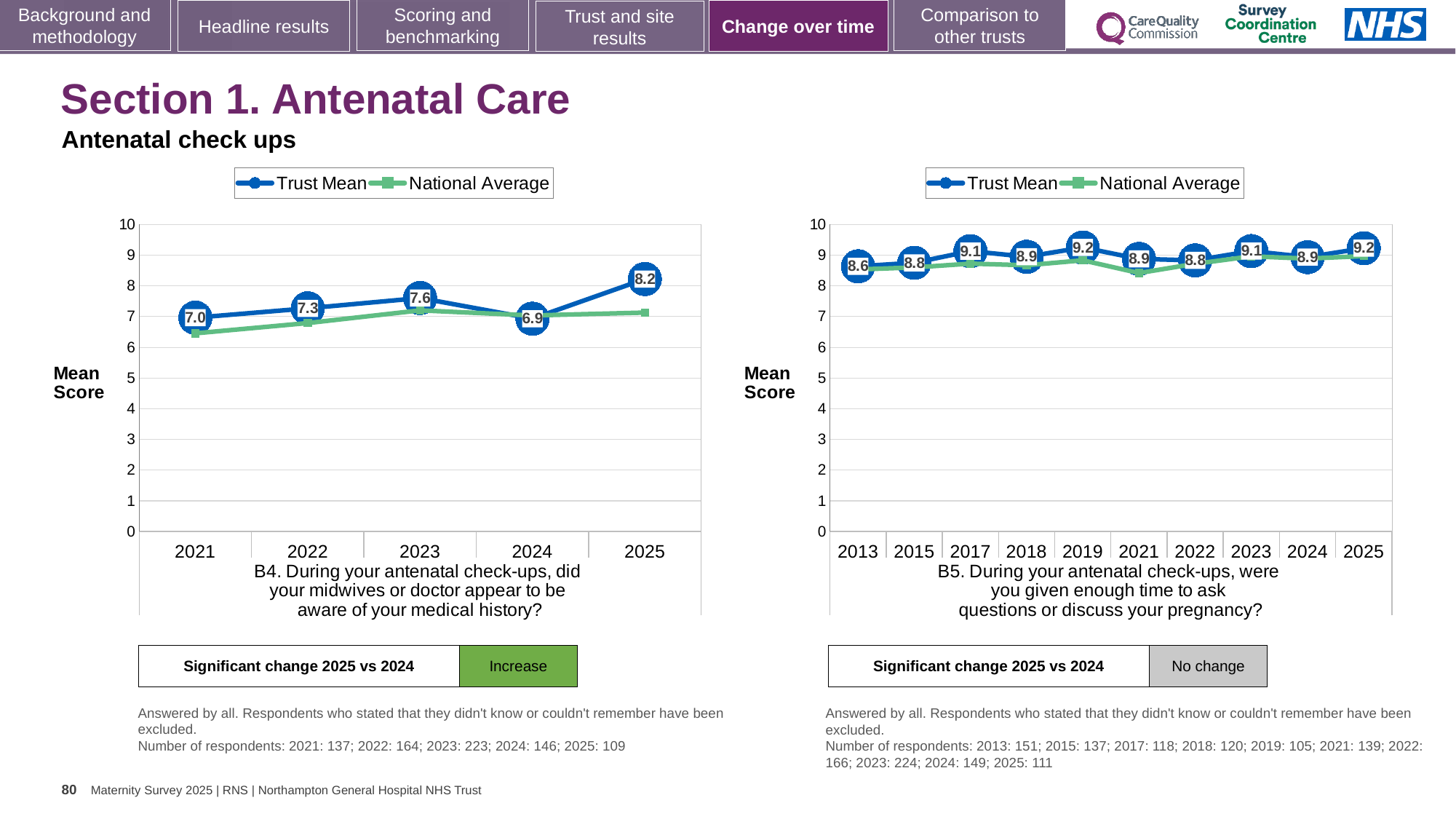
On the left chart (B4), is the National Average value for 2021 greater or less than 7? less On the right chart (B5), what is the Trust Mean score for 2013? 8.6 On the left chart (B4), what is the difference between the Trust Mean scores for 2025 and 2024? 1.3 On the left chart (B4), which year has the lowest Trust Mean score? 2024 On the right chart (B5), is the Trust Mean score for 2019 larger or smaller than the score for 2021? larger On the left chart (B4), what is the Trust Mean score for 2023? 7.6 On the right chart (B5), how many years are plotted on the x axis? 10 On the right chart (B5), which year has the lowest Trust Mean score? 2013 On the left chart (B4), which year has the highest Trust Mean score? 2025 On the left chart (B4), how many years are plotted on the x axis? 5 How many series does the legend of the right chart (B5) list? 2 On the left chart (B4), what is the Trust Mean score for 2025? 8.2